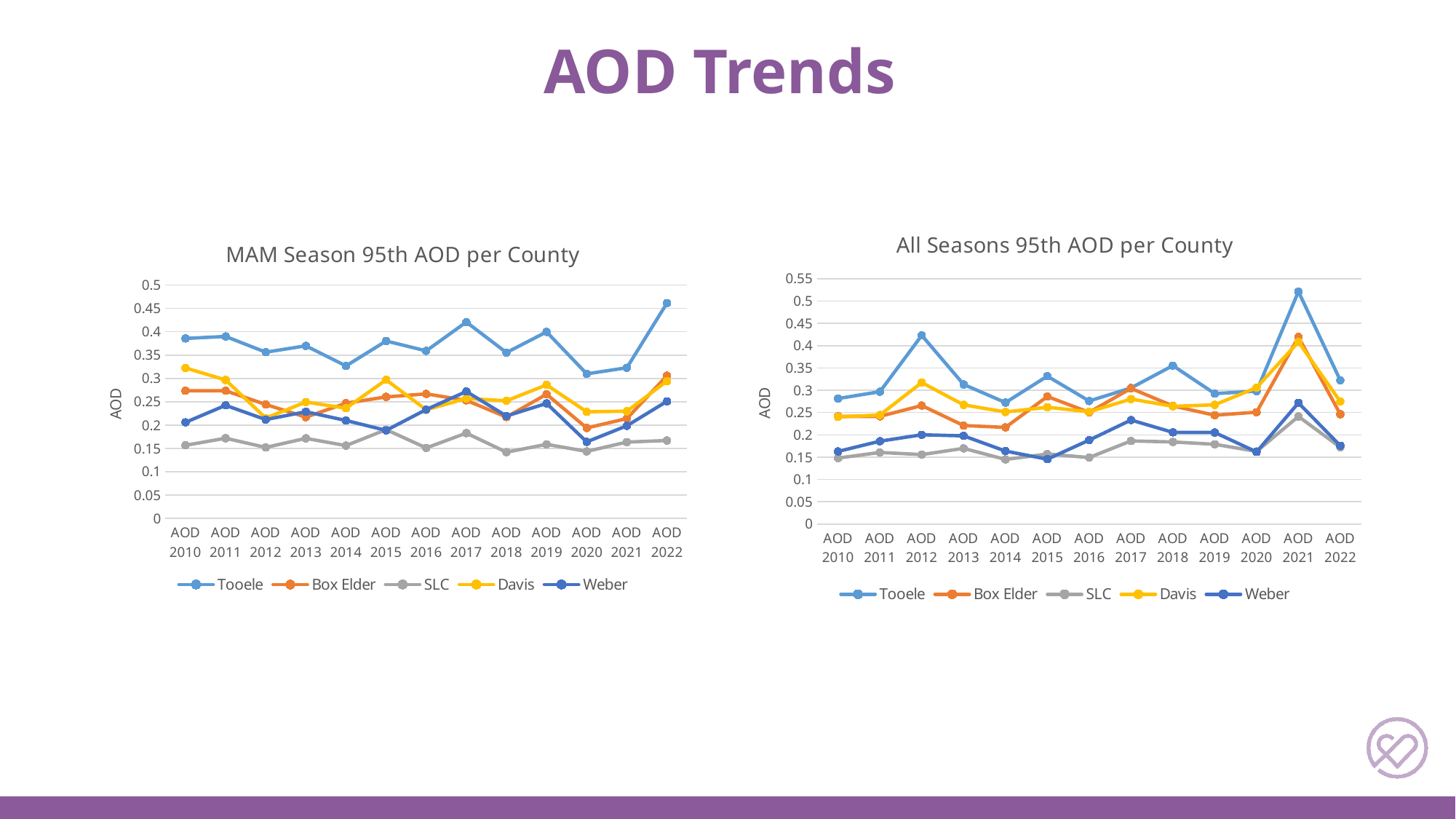
In the 'All Seasons 95th AOD per County' chart, which is larger in AOD 2012: Tooele or Box Elder? Tooele In the 'All Seasons 95th AOD per County' chart, in which year does Tooele reach its highest value? AOD 2021 In the 'MAM Season 95th AOD per County' chart, is the Tooele value for AOD 2022 greater or less than 0.4? greater In the 'All Seasons 95th AOD per County' chart, does the Tooele line rise or fall from AOD 2021 to AOD 2022? fall In the 'MAM Season 95th AOD per County' chart, which county has the highest value in AOD 2022? Tooele In the 'All Seasons 95th AOD per County' chart, is the Tooele value for AOD 2021 greater or less than 0.5? greater In the 'MAM Season 95th AOD per County' chart, which county has the lowest value in AOD 2010? SLC How many years are plotted along the x axis of the 'MAM Season 95th AOD per County' chart? 13 How many series does the legend of the 'All Seasons 95th AOD per County' chart list? 5 In the 'MAM Season 95th AOD per County' chart, is the SLC value for AOD 2017 greater or less than 0.2? less What kind of chart is the 'MAM Season 95th AOD per County' chart? line chart What is the y-axis label on the 'All Seasons 95th AOD per County' chart? AOD